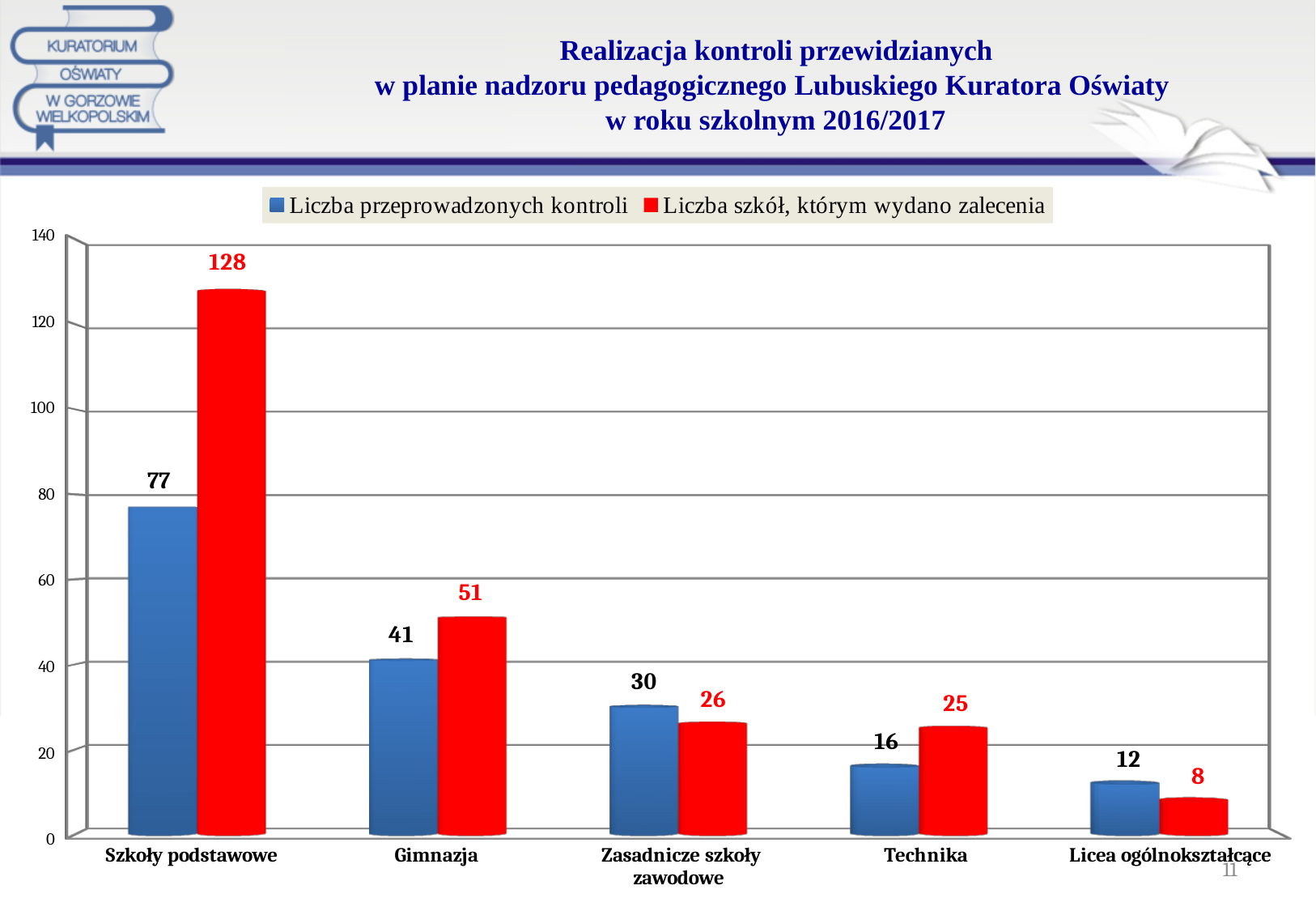
What is the value of "Liczba szkół, którym wydano zalecenia" for Licea ogólnokształcące? 8 How many series does the legend list? 2 Which category has the highest value for "Liczba szkół, którym wydano zalecenia"? Szkoły podstawowe What is the difference between "Liczba szkół, którym wydano zalecenia" and "Liczba przeprowadzonych kontroli" for Szkoły podstawowe? 51 How many categories are shown on the x axis? 5 Does the value of "Liczba przeprowadzonych kontroli" rise or fall from Szkoły podstawowe to Licea ogólnokształcące? fall What kind of chart is shown on the slide? bar chart What is the value of "Liczba szkół, którym wydano zalecenia" for Gimnazja? 51 Which category has the lowest value for "Liczba przeprowadzonych kontroli"? Licea ogólnokształcące For Zasadnicze szkoły zawodowe, which is larger: "Liczba przeprowadzonych kontroli" or "Liczba szkół, którym wydano zalecenia"? Liczba przeprowadzonych kontroli Is the value of "Liczba szkół, którym wydano zalecenia" for Szkoły podstawowe greater or less than 120? greater What is the value of "Liczba przeprowadzonych kontroli" for Szkoły podstawowe? 77